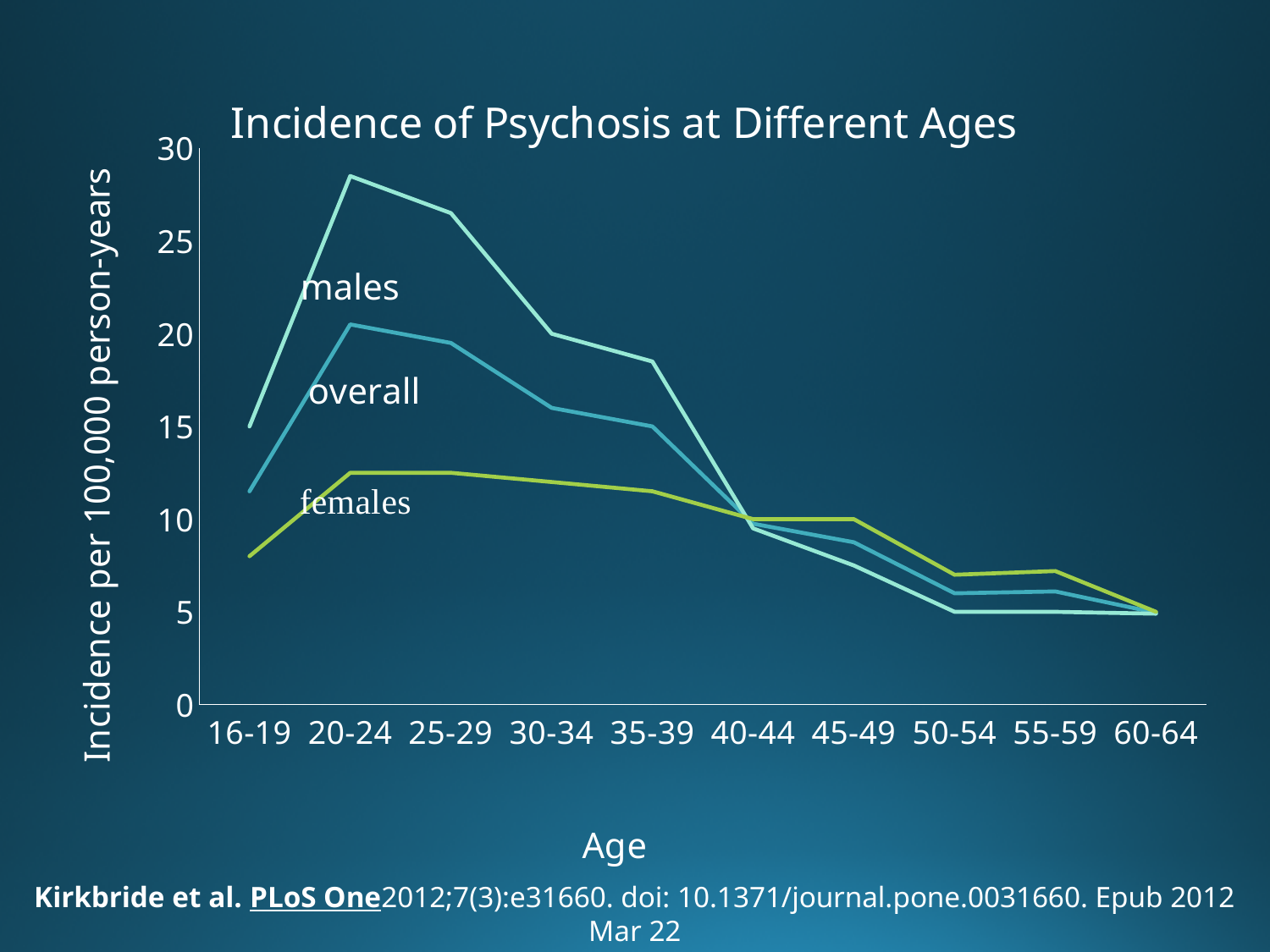
Is the value for females in the 25-29 age group greater or less than 15? less What is the label of the y axis? Incidence per 100,000 person-years What kind of chart is shown on the slide? line chart What is the title of the chart? Incidence of Psychosis at Different Ages In which age group does the males series reach its highest value? 20-24 How many series are plotted on the chart? 3 How many age groups are shown on the x axis? 10 Which series has the higher value in the 50-54 age group, females or males? females Which series has the higher value in the 30-34 age group, males or females? males Is the value for overall in the 16-19 age group greater or less than 10? greater In which age group does the females series have its lowest value? 60-64 Is the value for males in the 20-24 age group greater or less than 25? greater